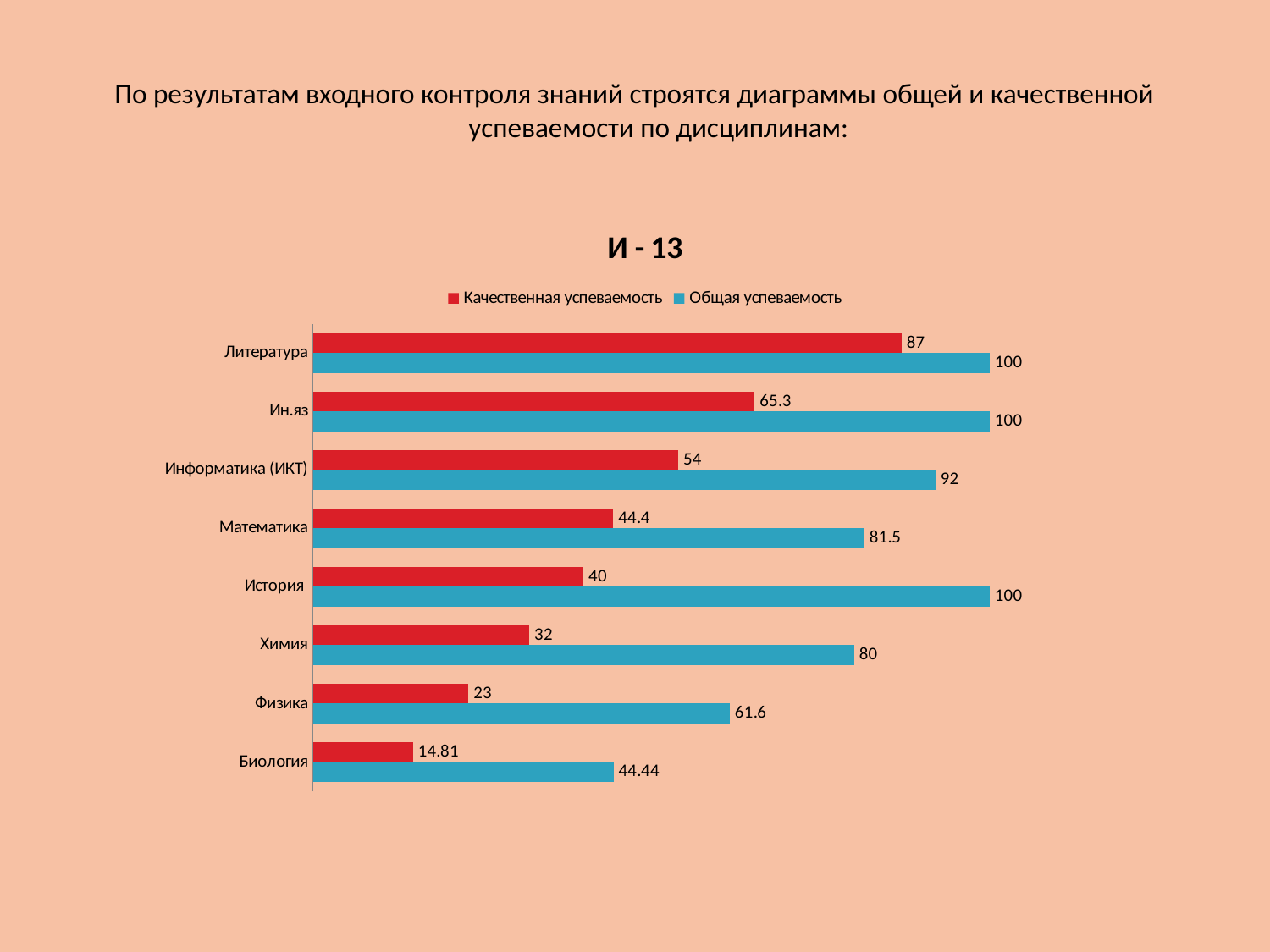
Which category has the lowest value of Общая успеваемость? Биология What is the value of Качественная успеваемость for Биология? 14.81 Which is larger: Качественная успеваемость for Химия or Качественная успеваемость for История? История Which category has the highest value of Качественная успеваемость? Литература What is the value of Качественная успеваемость for Литература? 87 What is the title of the chart? И - 13 What is the value of Общая успеваемость for Физика? 61.6 How many categories are shown on the chart? 8 What kind of chart is shown on the slide? bar chart Which colour represents Общая успеваемость in the chart? blue How many series does the legend list? 2 What is the difference between Общая успеваемость and Качественная успеваемость for Математика? 37.1